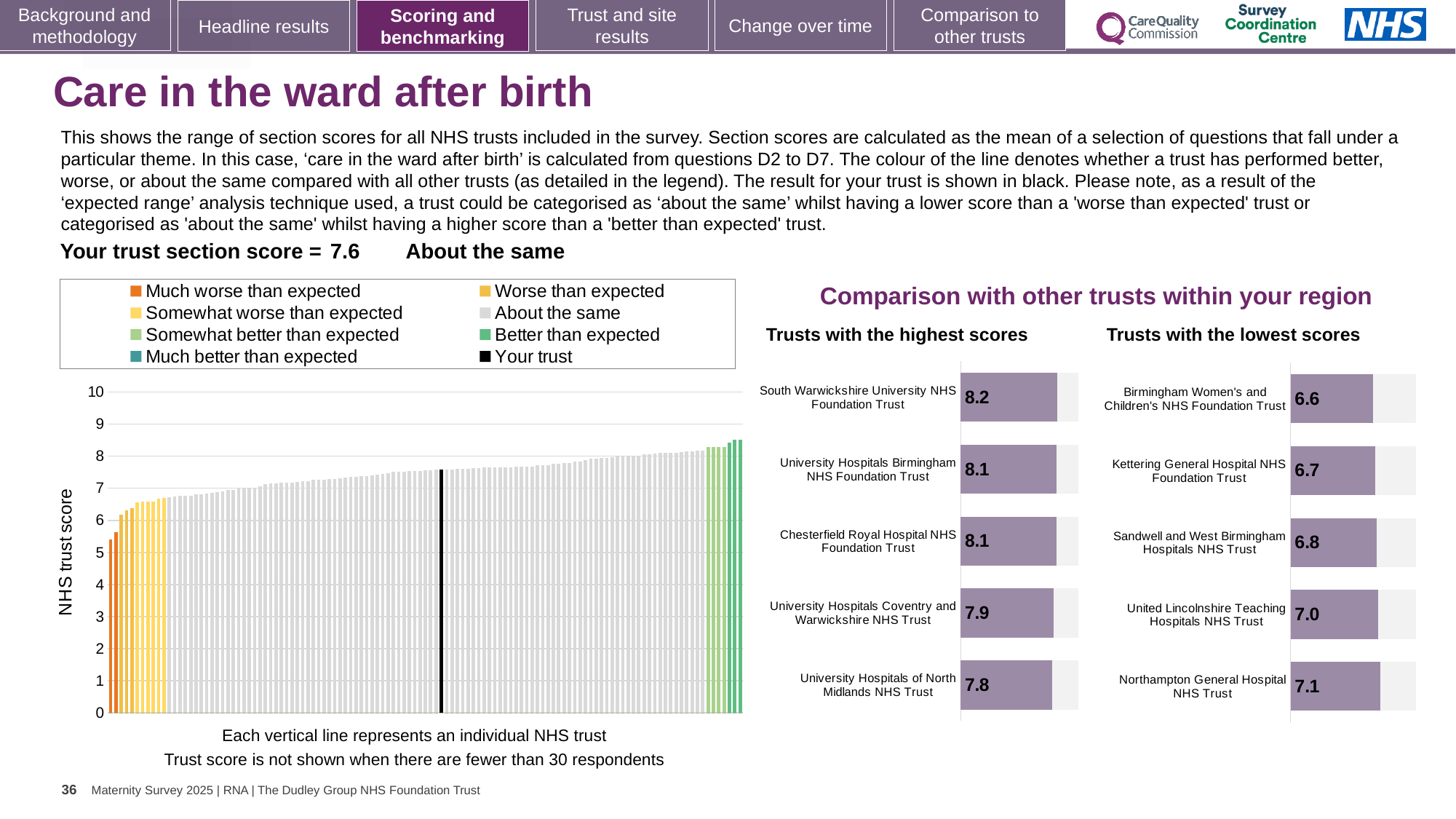
In the main 'NHS trust score' chart on the left, do the trust scores rise or fall from left to right? rise In the main 'NHS trust score' chart on the left, is the value for the black 'Your trust' bar greater or less than 7? greater How many trusts are listed in the 'Trusts with the highest scores' chart? 5 In the 'Trusts with the highest scores' chart, what is the score for South Warwickshire University NHS Foundation Trust? 8.2 In the 'Trusts with the lowest scores' chart, which has the larger score: Kettering General Hospital NHS Foundation Trust or Northampton General Hospital NHS Trust? Northampton General Hospital NHS Trust What kind of chart is the 'Trusts with the lowest scores' chart? bar chart What is the title of the section containing the two horizontal bar charts on the right? Comparison with other trusts within your region How many entries does the legend above the main 'NHS trust score' chart list? 8 In the 'Trusts with the highest scores' chart, which trust has the highest score? South Warwickshire University NHS Foundation Trust In the 'Trusts with the lowest scores' chart, which trust has the lowest score? Birmingham Women's and Children's NHS Foundation Trust In the 'Trusts with the lowest scores' chart, what is the score for Sandwell and West Birmingham Hospitals NHS Trust? 6.8 In the 'Trusts with the highest scores' chart, what is the difference between the scores of South Warwickshire University NHS Foundation Trust and University Hospitals of North Midlands NHS Trust? 0.4